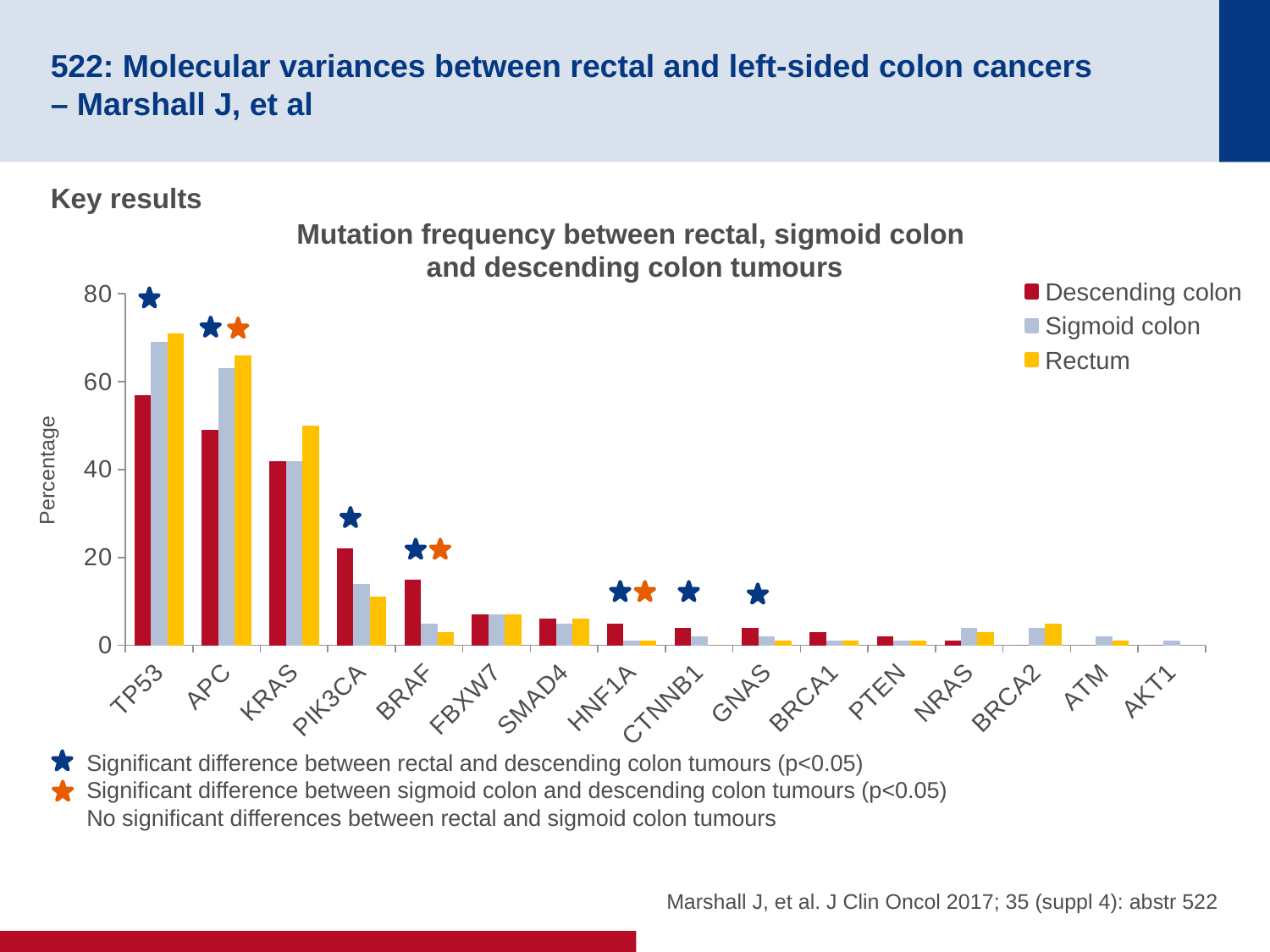
What kind of chart is shown on the slide? bar chart Is the Descending colon value for APC greater or less than 60? less Is the Descending colon value for BRAF greater or less than 20? less Is the Rectum value for TP53 greater or less than 60? greater How many gene categories are shown on the x axis? 16 How many series does the legend list? 3 What is the label on the y axis? Percentage For TP53, which series has the lowest value? Descending colon Do the Descending colon values generally rise or fall from left to right along the x axis? fall Which gene has the highest Rectum mutation frequency? TP53 For BRAF, which is larger: the Descending colon value or the Rectum value? Descending colon